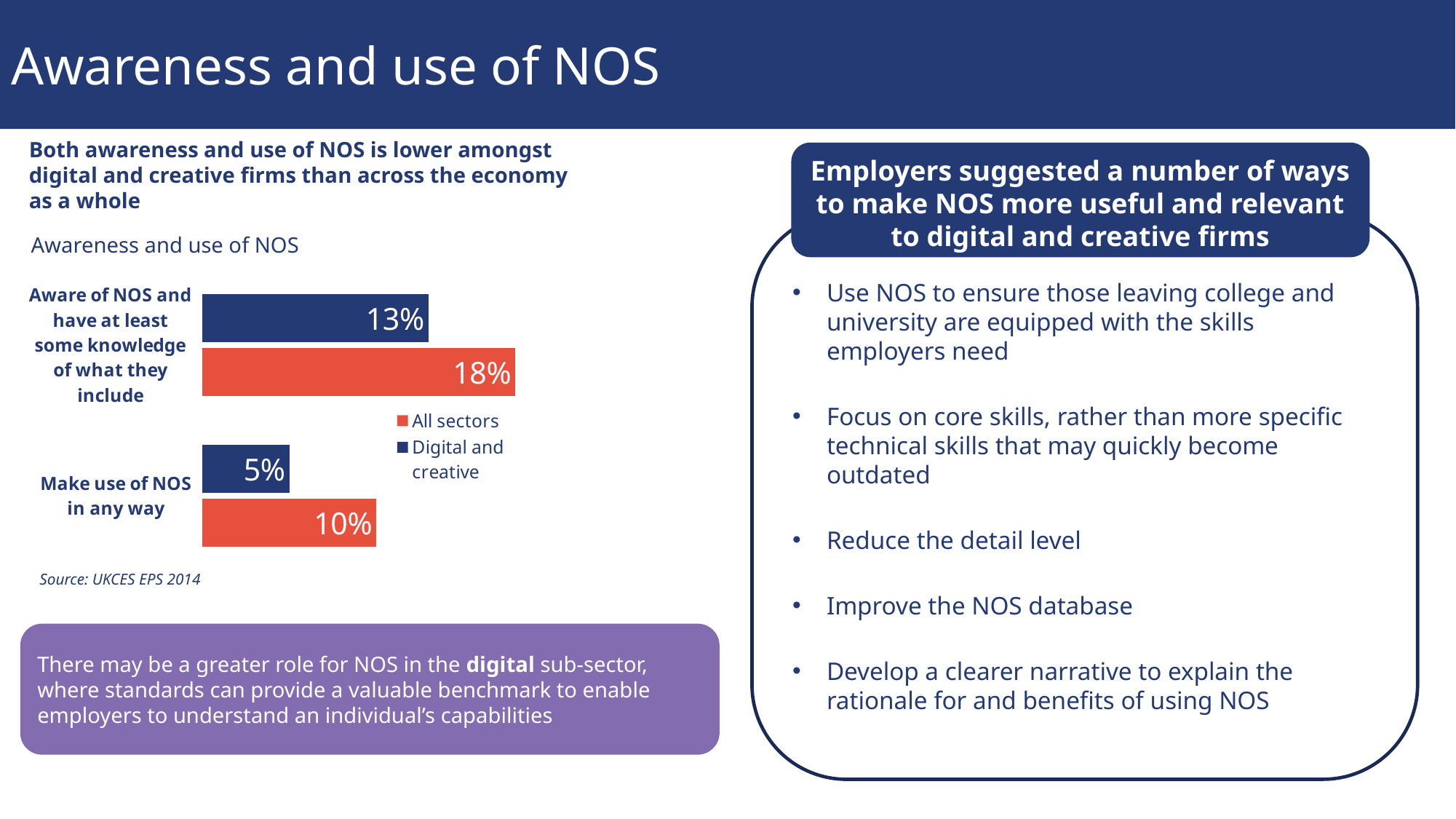
What is the value for 'All sectors' in the 'Make use of NOS in any way' category? 10% How many categories are shown in the chart? 2 How many series does the chart legend list? 2 What is the value for 'Digital and creative' in the 'Make use of NOS in any way' category? 5% What type of chart is shown on the slide? Bar chart What is the difference between 'All sectors' and 'Digital and creative' for 'Aware of NOS and have at least some knowledge of what they include'? 5% Which series has the higher value for 'Make use of NOS in any way'? All sectors What is the value for 'All sectors' in the 'Aware of NOS and have at least some knowledge of what they include' category? 18% Which bar in the chart has the lowest value? Digital and creative, Make use of NOS in any way What is the difference between 'All sectors' and 'Digital and creative' for 'Make use of NOS in any way'? 5% What is the value for 'Digital and creative' in the 'Aware of NOS and have at least some knowledge of what they include' category? 13% Which bar in the chart has the highest value? All sectors, Aware of NOS and have at least some knowledge of what they include